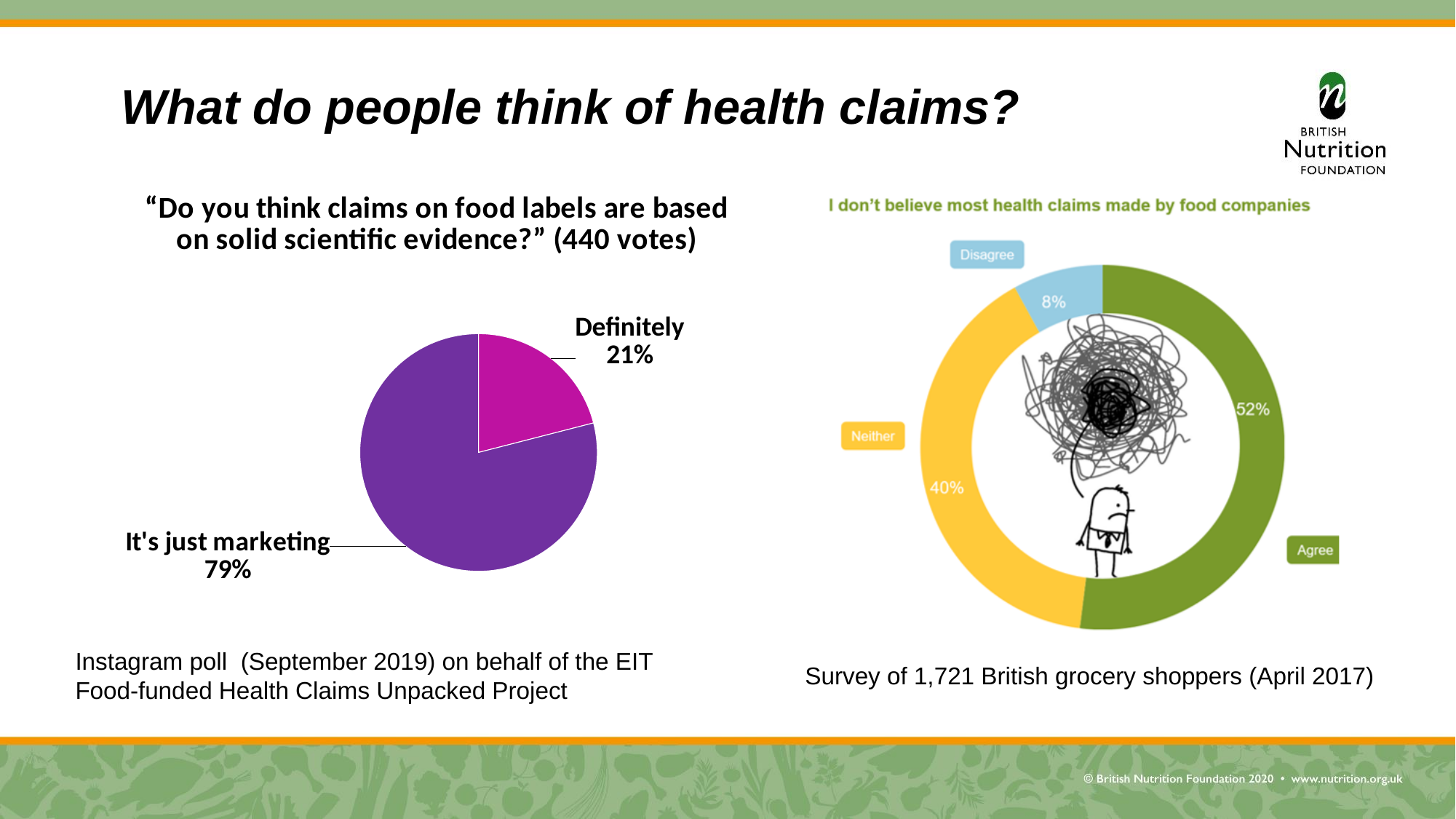
In the left pie chart, what percentage of votes was for "It's just marketing"? 79% In the right chart titled "I don't believe most health claims made by food companies", what percentage of shoppers chose "Disagree"? 8% In the right chart titled "I don't believe most health claims made by food companies", which response has the smallest share? Disagree In the left pie chart, which response received the largest share of votes? It's just marketing In the right chart titled "I don't believe most health claims made by food companies", what is the difference in percentage points between "Agree" and "Neither"? 12 In the right chart titled "I don't believe most health claims made by food companies", what percentage of shoppers chose "Agree"? 52% In the left pie chart, what is the difference in percentage points between "It's just marketing" and "Definitely"? 58 In the right chart titled "I don't believe most health claims made by food companies", what percentage of shoppers chose "Neither"? 40% How many slices does the left pie chart have? 2 What type of chart is the chart on the left of the slide? Pie chart How many votes does the title of the left pie chart say were cast? 440 votes In the left pie chart, what percentage of votes was for "Definitely"? 21%